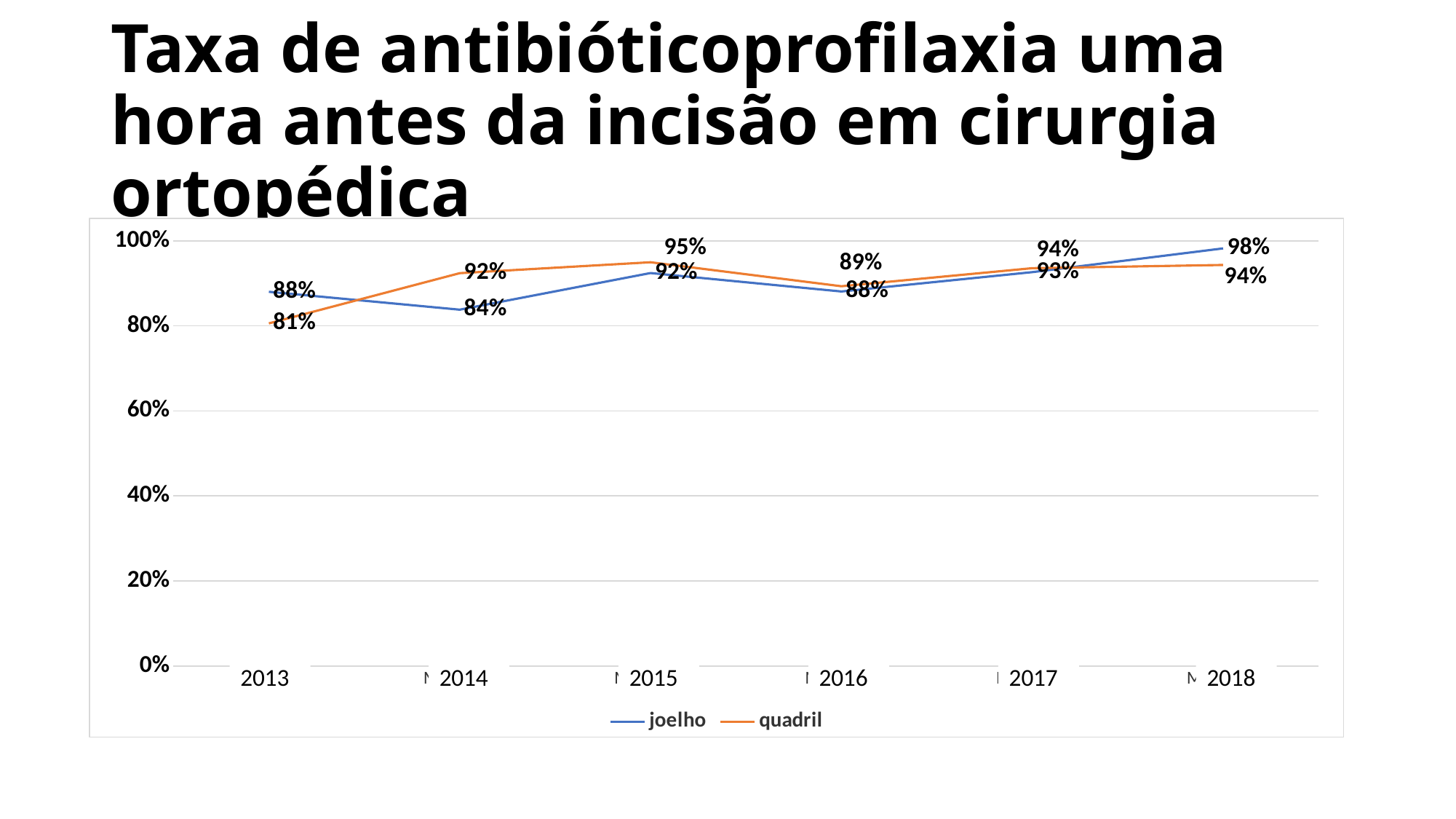
In which year is the joelho value highest? 2018 What is the value for joelho in 2018? 98% In which year is the quadril value lowest? 2013 Which series has the larger value in 2014, joelho or quadril? quadril Which colour is used for the quadril series? orange What is the value for quadril in 2014? 92% What is the difference between the joelho and quadril values in 2013? 7% How many years are shown on the x axis? 6 How many series does the legend list? 2 What is the value for joelho in 2013? 88% What is the value for quadril in 2015? 95% What kind of chart is shown on the slide? line chart